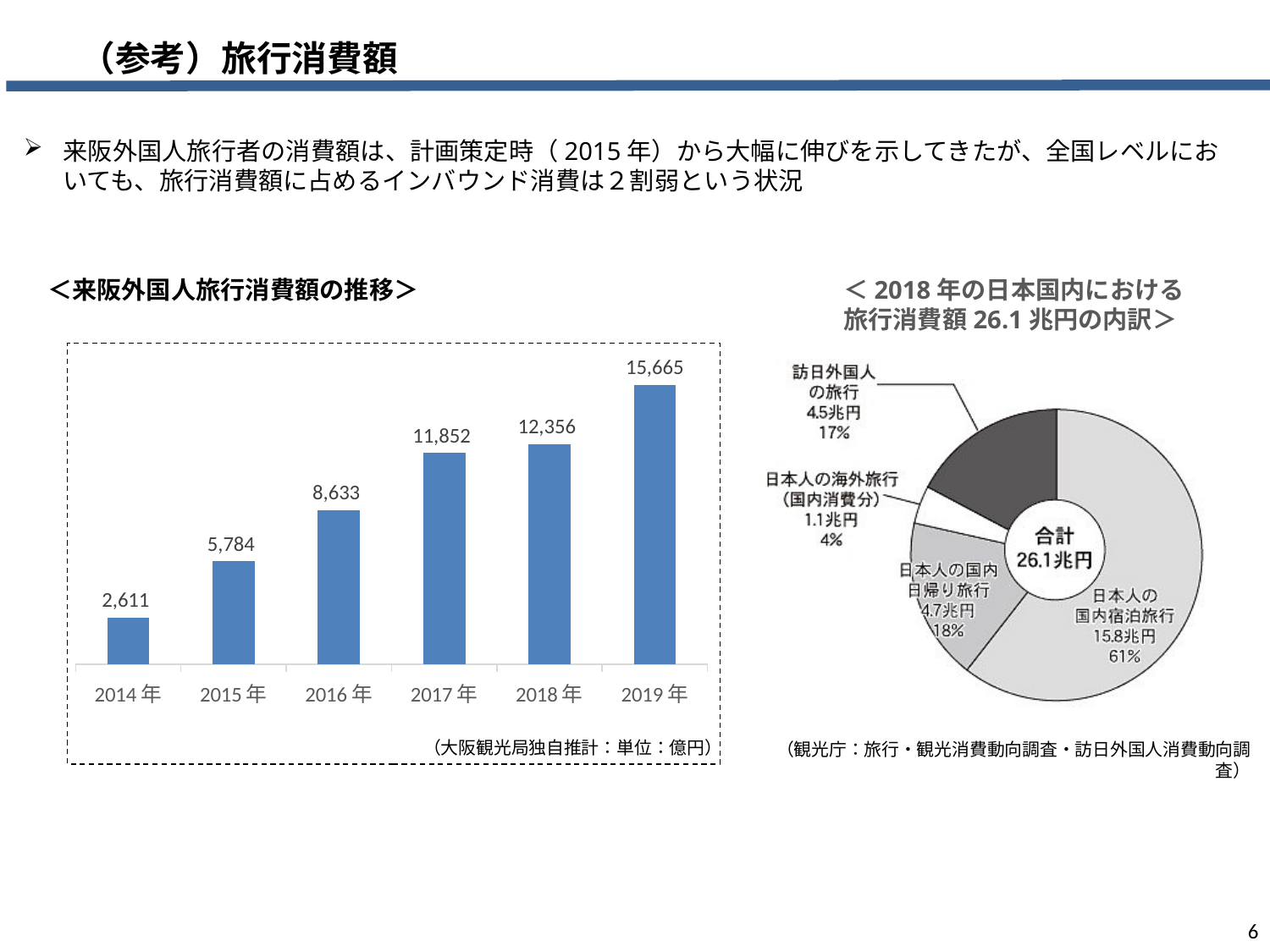
In the pie chart on the right (2018年の日本国内における旅行消費額26.1兆円の内訳), what is the value for 訪日外国人の旅行? 4.5兆円 In the bar chart titled 来阪外国人旅行消費額の推移, what is the value for 2019年? 15,665 In the bar chart titled 来阪外国人旅行消費額の推移, how many years are plotted? 6 In the bar chart titled 来阪外国人旅行消費額の推移, do the values rise or fall from 2014年 to 2019年? rise In the bar chart titled 来阪外国人旅行消費額の推移, which year has the lowest value? 2014年 In the bar chart titled 来阪外国人旅行消費額の推移, what is the difference between the values for 2019年 and 2018年? 3,309 In the pie chart on the right (2018年の日本国内における旅行消費額26.1兆円の内訳), what share does 日本人の国内宿泊旅行 have? 61% In the pie chart on the right (2018年の日本国内における旅行消費額26.1兆円の内訳), which slice is the smallest? 日本人の海外旅行（国内消費分） In the bar chart titled 来阪外国人旅行消費額の推移, which year has the highest value? 2019年 In the pie chart on the right (2018年の日本国内における旅行消費額26.1兆円の内訳), which is larger: 日本人の国内日帰り旅行 or 訪日外国人の旅行? 日本人の国内日帰り旅行 What kind of chart is the chart on the left of the slide (来阪外国人旅行消費額の推移)? bar chart In the bar chart titled 来阪外国人旅行消費額の推移, what is the value for 2016年? 8,633